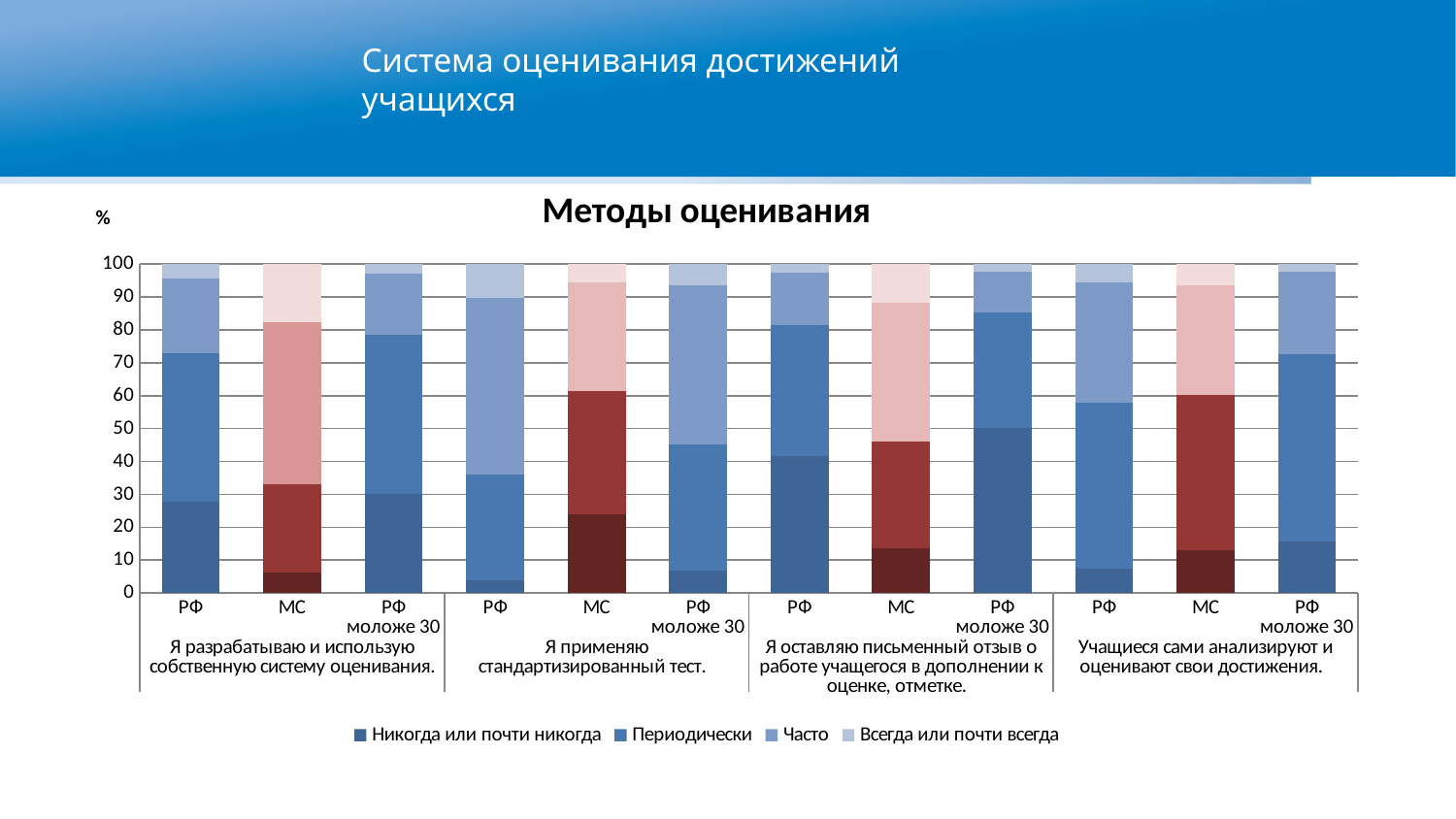
Is the 'Никогда или почти никогда' value for МС in the group 'Я разрабатываю и использую собственную систему оценивания.' greater or less than 10? less How many series does the legend list? 4 Is the 'Никогда или почти никогда' value for РФ моложе 30 in the group 'Я оставляю письменный отзыв о работе учащегося в дополнении к оценке, отметке.' greater or less than 40? greater Which bar has the largest 'Никогда или почти никогда' segment in the chart? РФ моложе 30 in 'Я оставляю письменный отзыв о работе учащегося в дополнении к оценке, отметке.' What kind of chart is shown on the slide? Stacked bar chart In the group 'Я разрабатываю и использую собственную систему оценивания.', which has the larger 'Никогда или почти никогда' value, РФ or МС? РФ How many question groups are shown along the x axis? 4 Is the 'Никогда или почти никогда' value for РФ in the group 'Я применяю стандартизированный тест.' greater or less than 10? less What is the total height of the stacked bar for РФ in the group 'Я разрабатываю и использую собственную систему оценивания.'? 100 How many bars are plotted in the chart? 12 What is the title of the chart? Методы оценивания